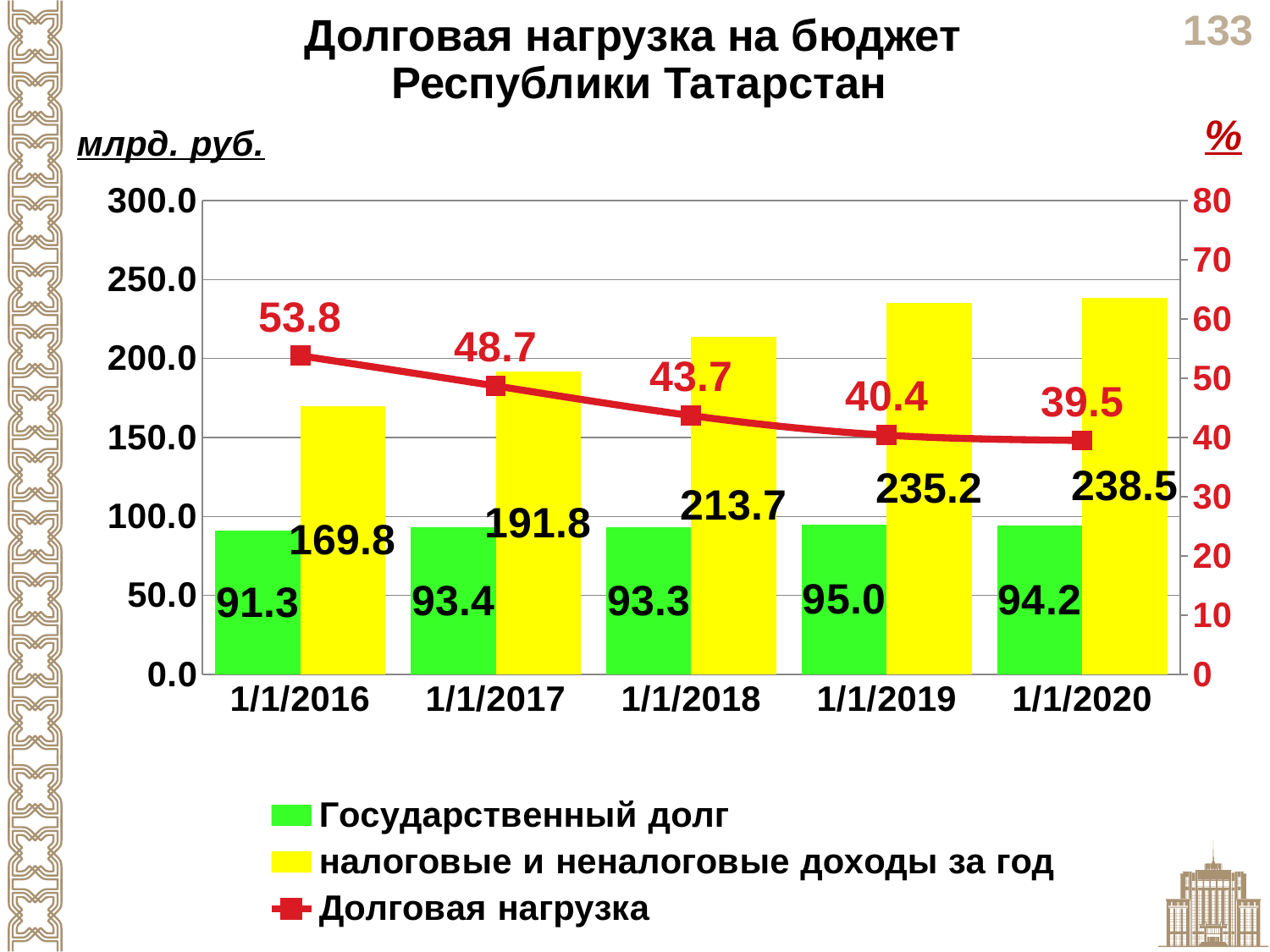
How many dates are shown on the x axis? 5 What is the difference between налоговые и неналоговые доходы за год on 1/1/2020 and on 1/1/2016? 68.7 In which year is Государственный долг the highest? 1/1/2019 How many series does the legend list? 3 What is the value of Государственный долг on 1/1/2018? 93.3 In which year is налоговые и неналоговые доходы за год the lowest? 1/1/2016 What is the Долговая нагрузка value on 1/1/2016? 53.8 Does the Долговая нагрузка line rise or fall from 1/1/2016 to 1/1/2020? Falls Which is larger: Государственный долг on 1/1/2017 or on 1/1/2020? 1/1/2020 What colour are the bars for Государственный долг? Green What is the value of налоговые и неналоговые доходы за год on 1/1/2020? 238.5 What kind of chart is shown on the slide? Combined bar and line chart